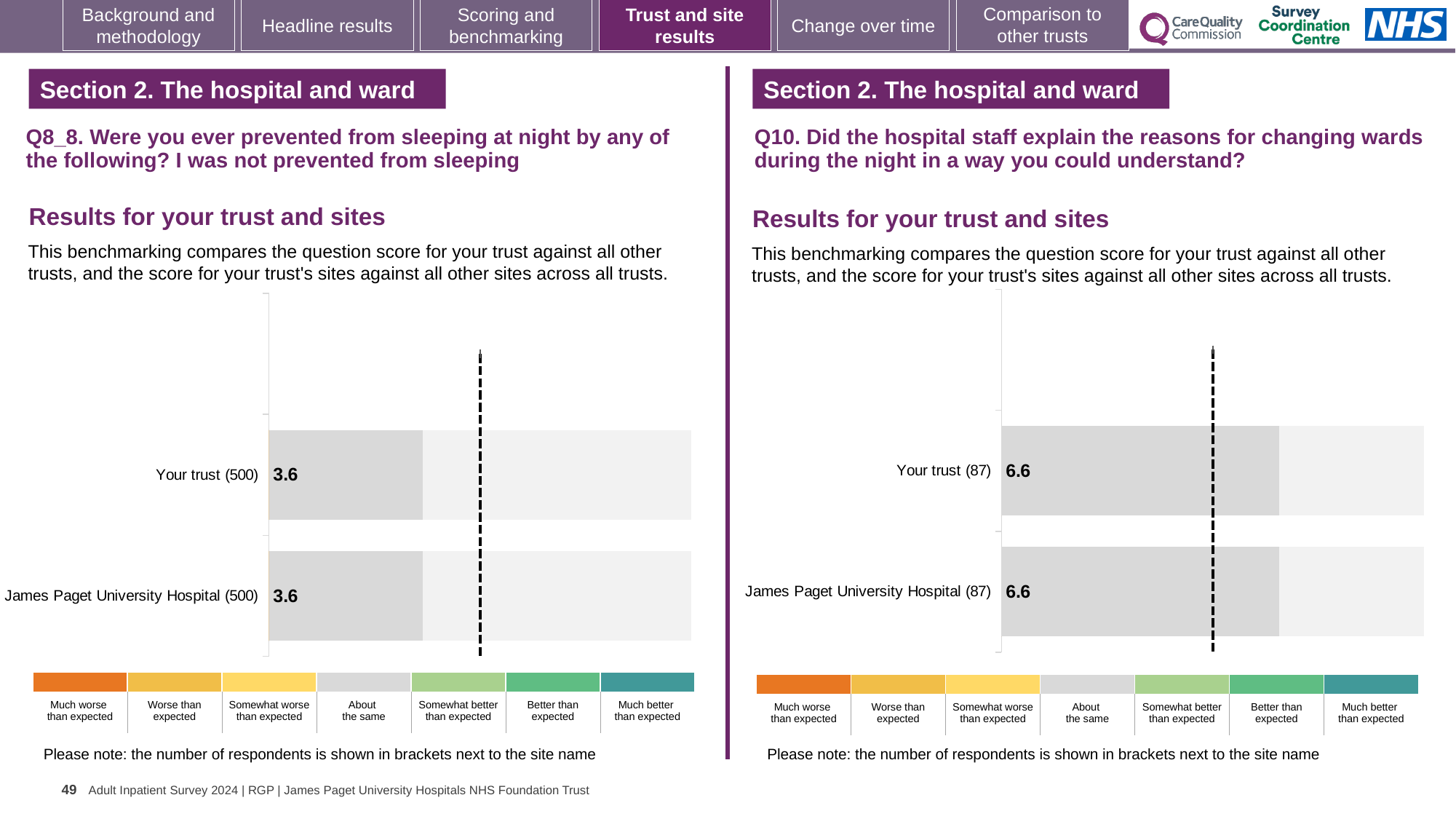
On the left chart (Q8_8), how many respondents are shown in brackets for Your trust? 500 On the left chart (Q8_8), how many bars are plotted? 2 On the left chart (Q8_8), what is the difference between the score for Your trust and the score for James Paget University Hospital? 0 What kind of chart is used on the left (Q8_8)? Bar chart On the right chart (Q10), how many bars are plotted? 2 On the left chart (Q8_8), what is the score for James Paget University Hospital? 3.6 On the right chart (Q10), what is the score for Your trust? 6.6 On the right chart (Q10), what is the score for James Paget University Hospital? 6.6 On the right chart (Q10), what is the difference between the score for Your trust and the score for James Paget University Hospital? 0 On the right chart (Q10), how many respondents are shown in brackets for James Paget University Hospital? 87 On the left chart (Q8_8), what is the score for Your trust? 3.6 On the right chart (Q10), how many categories does the colour key below the chart list? 7